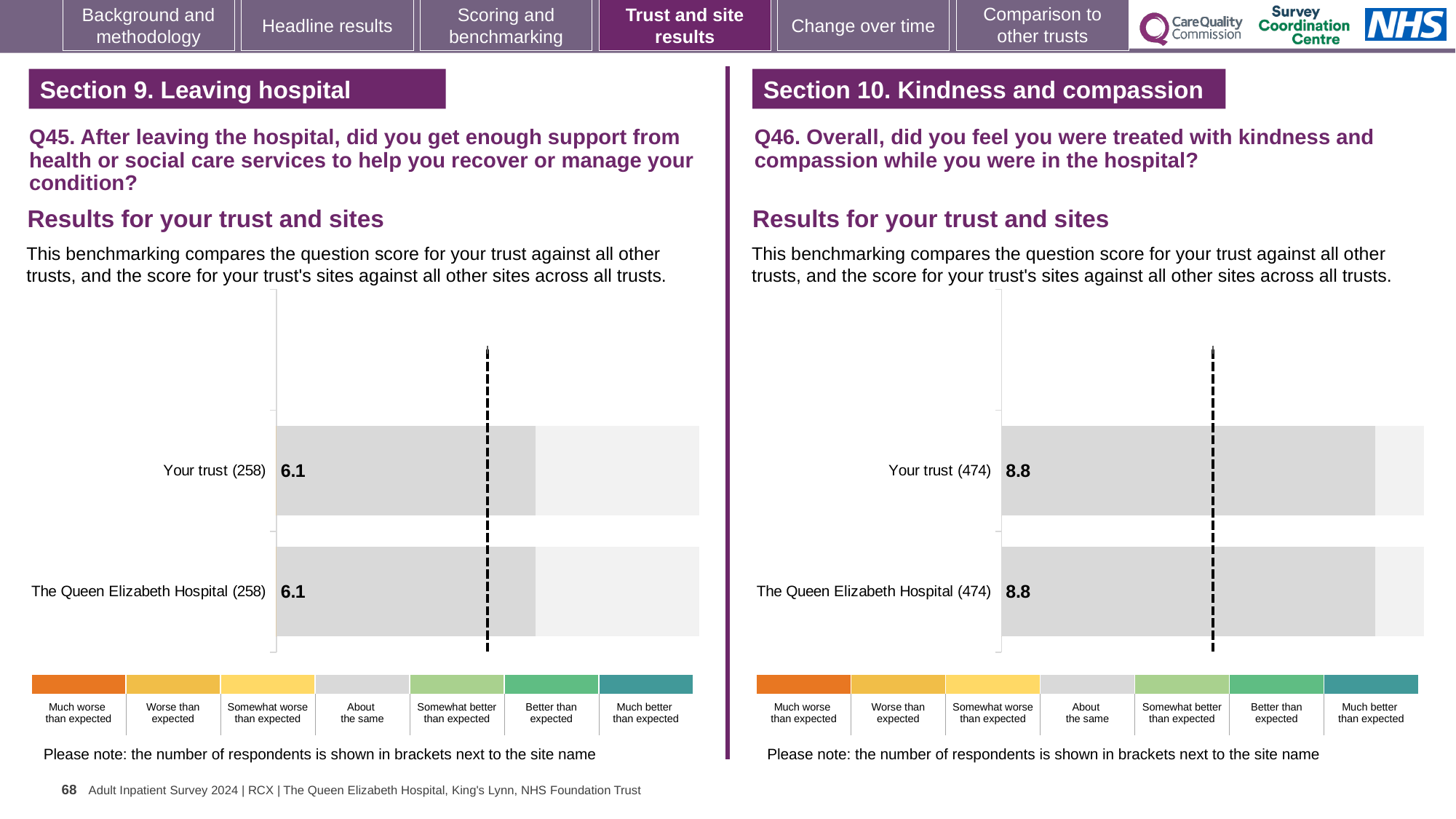
How many bars are plotted in the Q46 chart on the right? 2 In the Q46 chart on the right, how many respondents are shown in brackets next to The Queen Elizabeth Hospital? 474 How many bars are plotted in the Q45 chart on the left? 2 Is the score for Your trust in the Q46 chart on the right larger or smaller than the score for Your trust in the Q45 chart on the left? Larger What kind of chart is used for the Q45 results on the left? Bar chart In the Q45 chart on the left, what is the difference between the score for Your trust and the score for The Queen Elizabeth Hospital? 0 In the Q45 chart on the left, how many respondents are shown in brackets next to Your trust? 258 In the Q45 chart on the left, what is the score for Your trust? 6.1 In the Q46 chart on the right, what is the difference between the score for Your trust and the score for The Queen Elizabeth Hospital? 0 In the Q46 chart on the right, what is the score for Your trust? 8.8 In the Q45 chart on the left, what is the score for The Queen Elizabeth Hospital? 6.1 In the Q46 chart on the right, what is the score for The Queen Elizabeth Hospital? 8.8